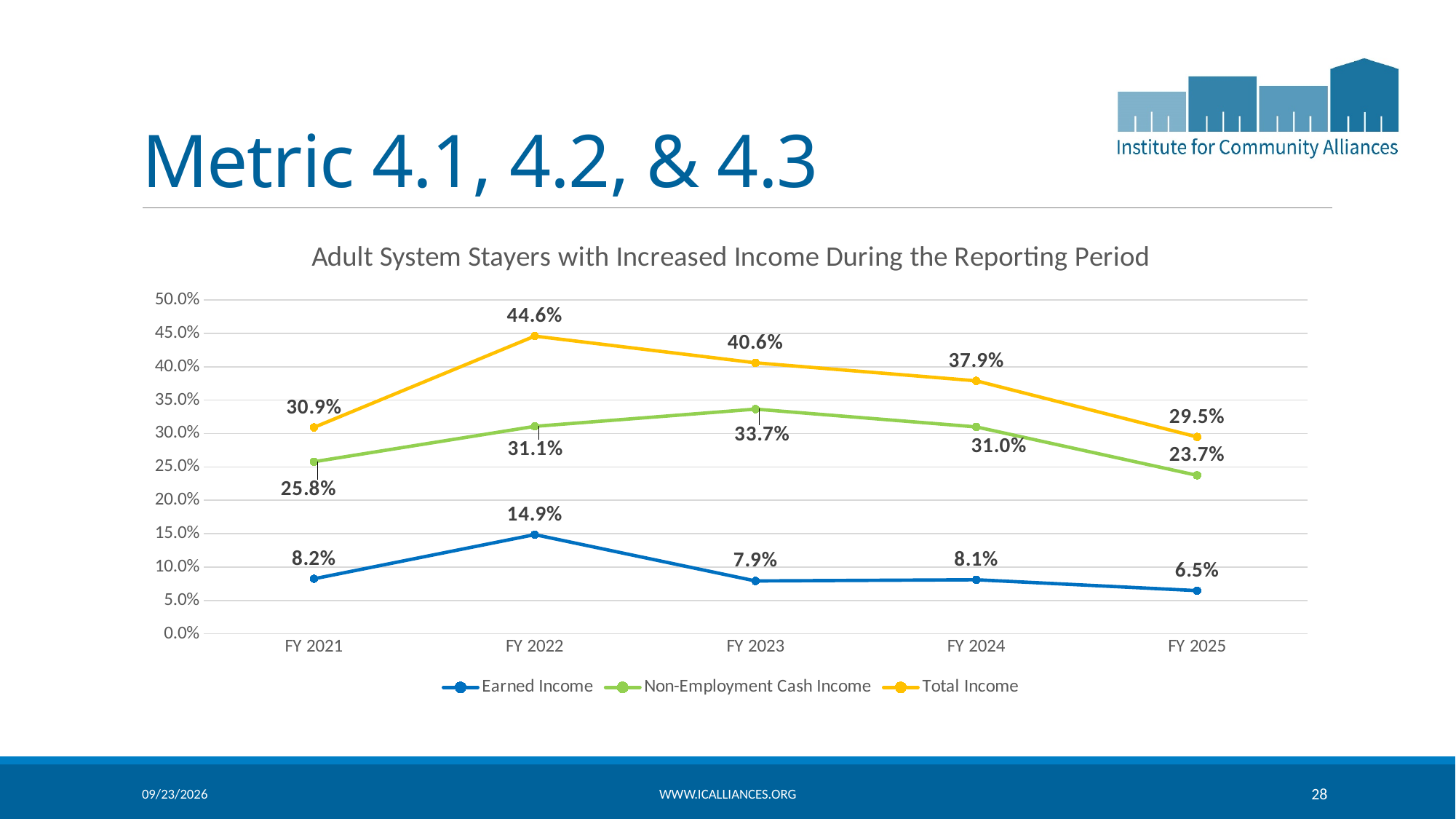
Does Total Income rise or fall from FY 2022 to FY 2025? fall Is the Total Income value for FY 2023 greater or less than 40.0%? greater How many series does the legend list? 3 How many fiscal years are shown on the x axis? 5 What is the Earned Income value for FY 2025? 6.5% In which fiscal year is Earned Income lowest? FY 2025 What is the difference between Total Income in FY 2022 and FY 2025? 15.1% What is the Non-Employment Cash Income value for FY 2021? 25.8% What kind of chart is shown on the slide? line chart What is the Total Income value for FY 2022? 44.6% In which fiscal year is Non-Employment Cash Income highest? FY 2023 Which is larger: Earned Income in FY 2022 or Earned Income in FY 2024? FY 2022